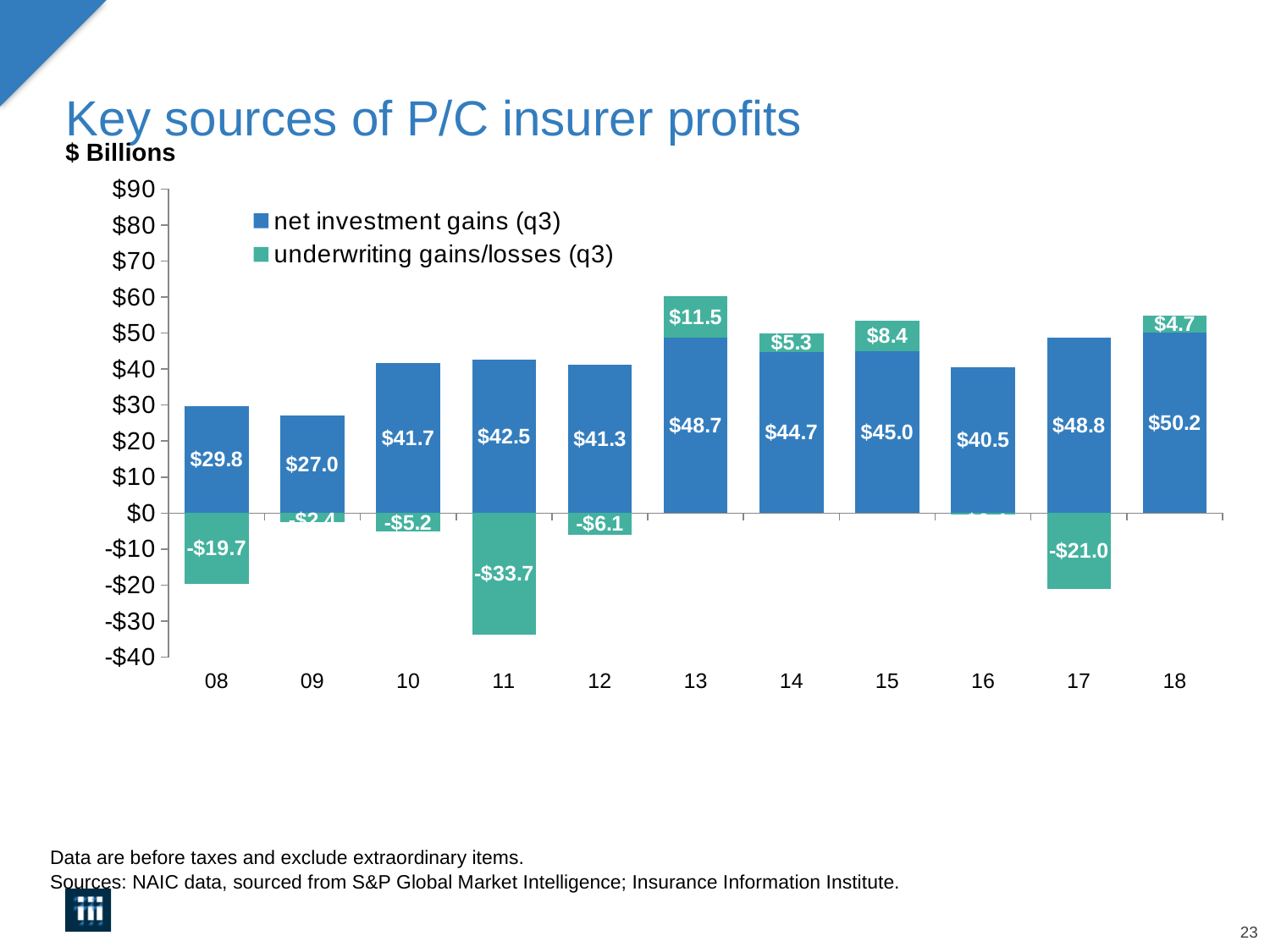
Which year has the lowest net investment gains (q3)? 09 What is the difference between net investment gains (q3) in 18 and in 08? $20.4 How many years are shown on the x axis? 11 What type of chart is shown on the slide? bar chart How many series does the legend list? 2 Which is larger, net investment gains (q3) in 13 or in 17? 17 Which year has the highest net investment gains (q3)? 18 What is the value of underwriting gains/losses (q3) for 11? -$33.7 What is the value of net investment gains (q3) for 18? $50.2 What is the value of underwriting gains/losses (q3) for 13? $11.5 What is the total of the stacked bar for 13? $60.2 Which year has the lowest underwriting gains/losses (q3)? 11